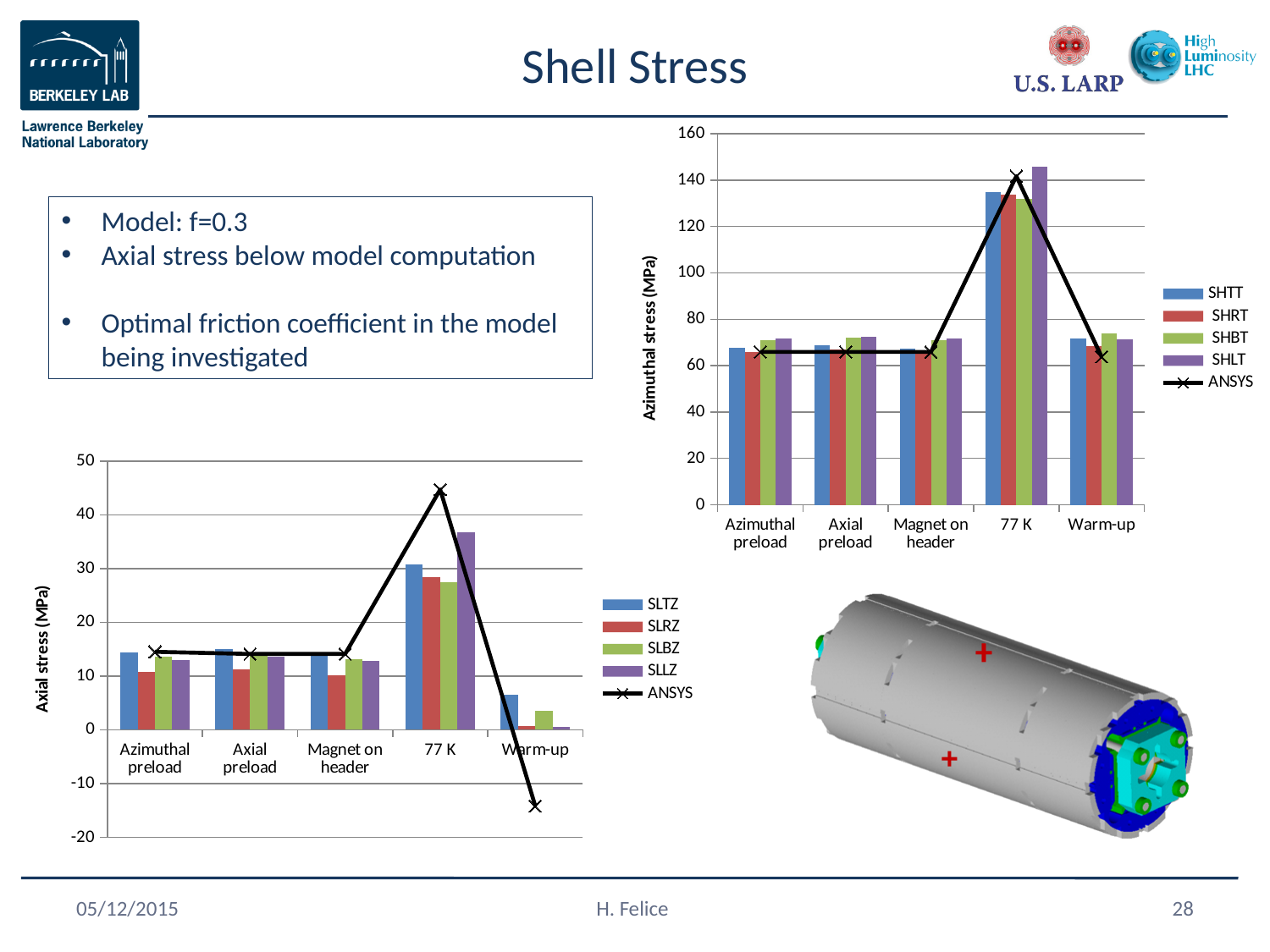
In the Azimuthal stress chart, how many series does the legend list? 5 In the Azimuthal stress chart, is the SHLT value at 77 K greater or less than 140? greater In the Axial stress chart, at 77 K, which is larger: SLTZ or SLLZ? SLLZ What kind of chart is the Axial stress chart (excluding the ANSYS line)? bar chart In the Axial stress chart, how many series does the legend list? 5 In the Azimuthal stress chart, is the SHTT value at Azimuthal preload greater or less than 60? greater In the Axial stress chart, is the ANSYS value at Warm-up greater or less than -10? less In the Azimuthal stress chart, which category has the highest stress values? 77 K In the Azimuthal stress chart, how many categories are shown on the x axis? 5 In the Azimuthal stress chart, at 77 K, which is larger: SHLT or SHTT? SHLT In the Axial stress chart, at which category does the ANSYS line reach its lowest value? Warm-up